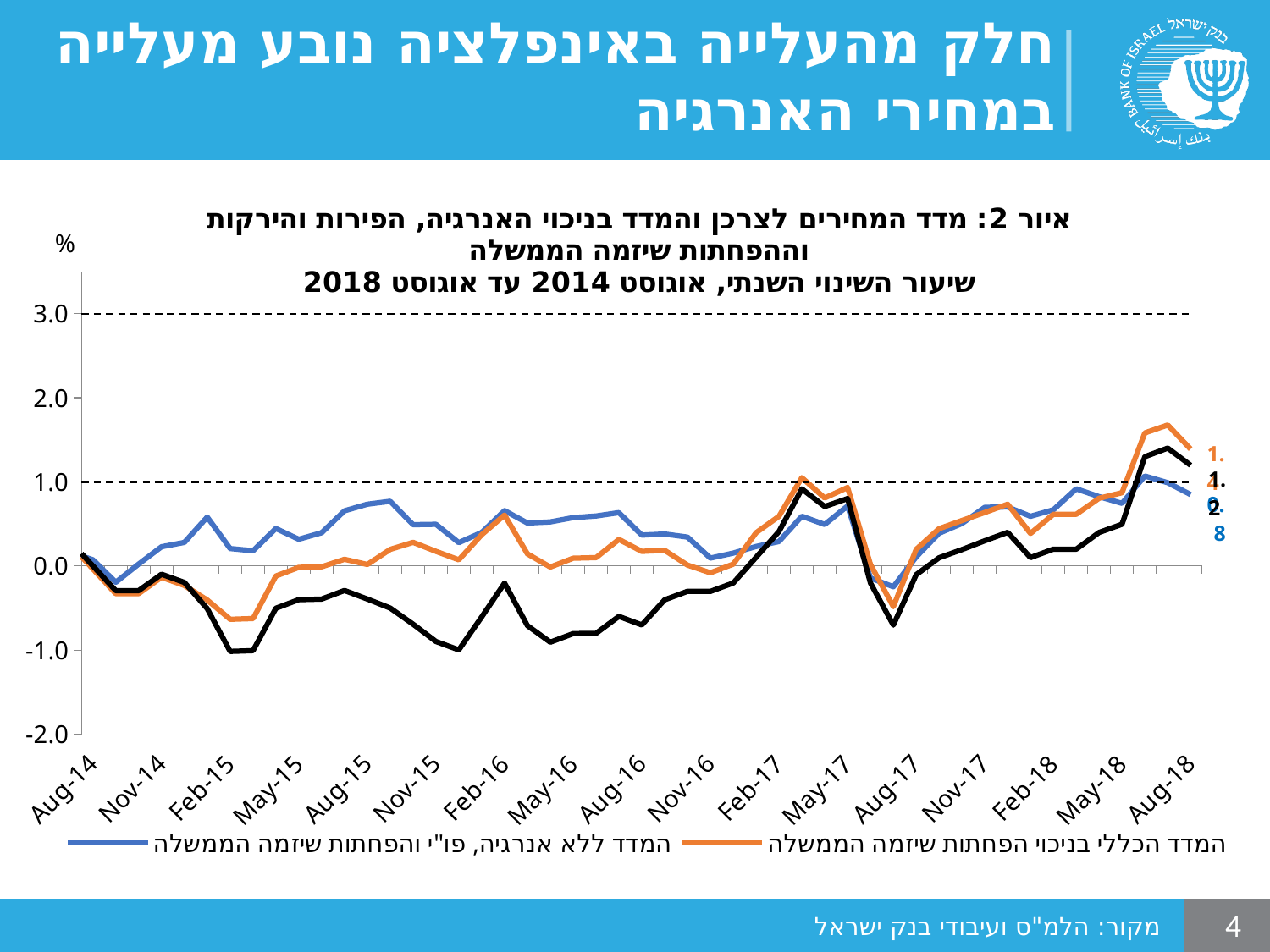
Is the value of the orange line at Aug-18 greater or less than 1.0? greater Which line has the lowest value at Feb-15: the orange, black or blue line? black At Aug-15, is the blue line higher or lower than the black line? higher How many series does the legend list? 3 Which line has the highest value at Aug-18: the orange, black or blue line? orange Is the value of the black line at Feb-15 greater or less than -0.5? less Is the value of the black line at Feb-16 greater or less than 0.0? less What kind of chart is shown on the slide? line chart What is the first x-axis label on the chart? Aug-14 Does the black line rise or fall between Aug-17 and Aug-18? rise What unit is shown on the y axis of the chart? %